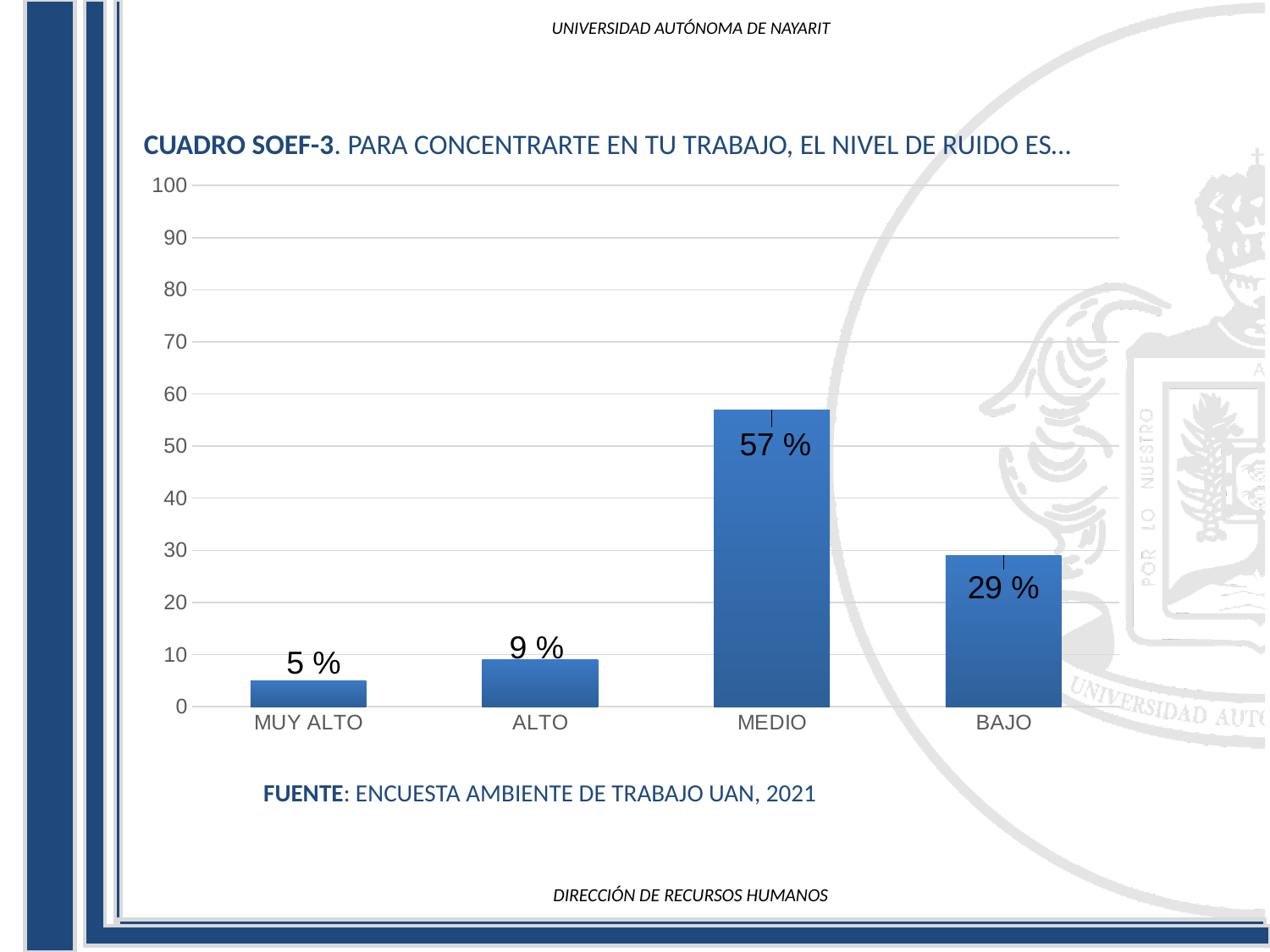
What is the value for BAJO? 29 % What is the value for MEDIO? 57 % What is the value for MUY ALTO? 5 % What kind of chart is shown on the slide? bar chart Which category has the lowest value? MUY ALTO Which is larger, the value for ALTO or the value for BAJO? BAJO What source is cited below the chart? ENCUESTA AMBIENTE DE TRABAJO UAN, 2021 How many categories are shown on the x axis? 4 Is the value for MEDIO greater or less than 50? greater What is the value for ALTO? 9 % What is the difference between the values for MEDIO and BAJO? 28 % Which category has the highest value? MEDIO